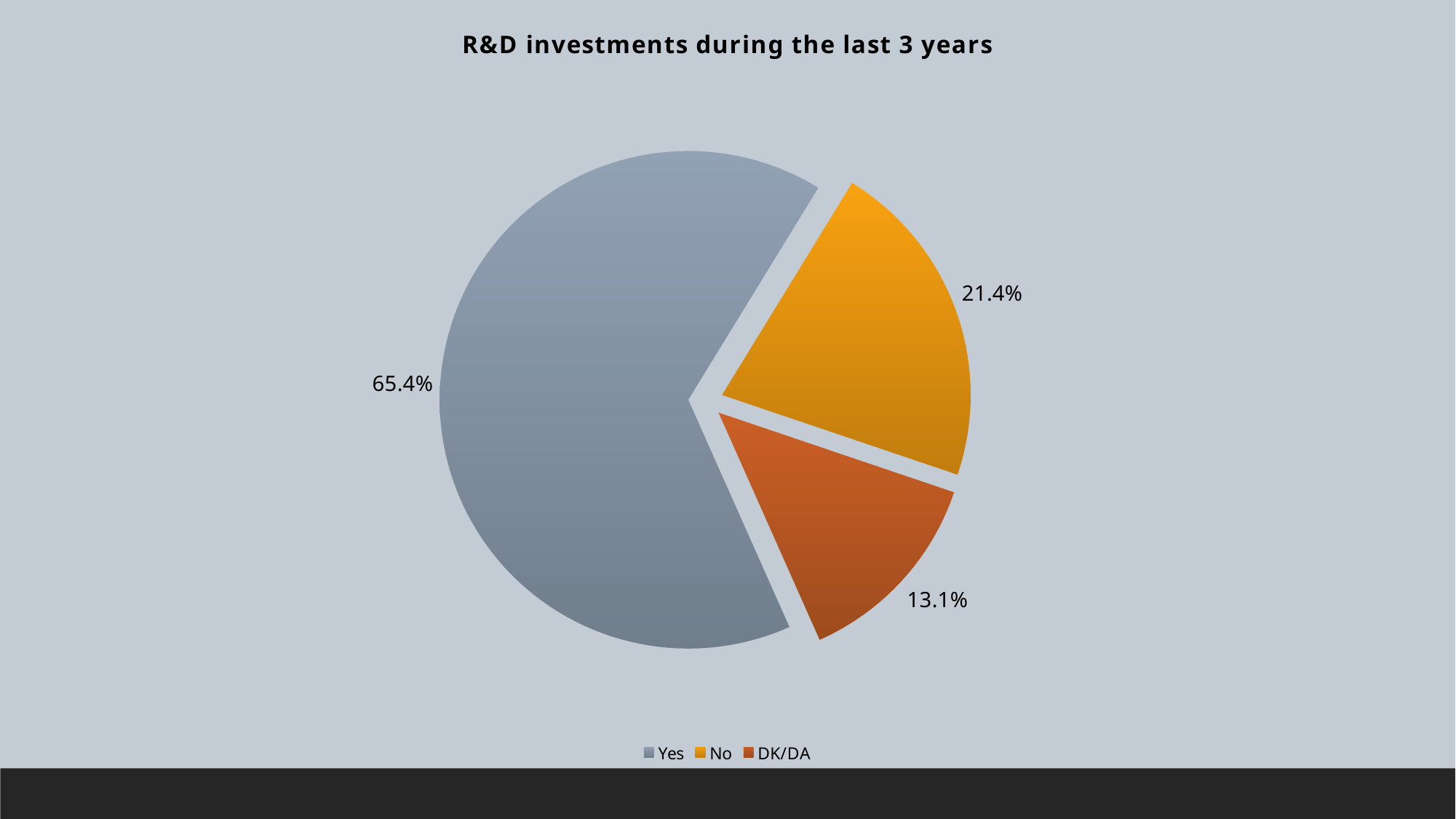
What share of the pie is labelled "Yes"? 65.4% What share of the pie is labelled "DK/DA"? 13.1% Which category has the smallest slice of the pie? DK/DA What is the title of the chart? R&D investments during the last 3 years What kind of chart is shown on the slide? pie chart What is the difference in percentage points between the "No" and "DK/DA" slices? 8.3 Which category has the largest slice of the pie? Yes How many slices does the pie chart have? 3 How many entries does the legend list? 3 What share of the pie is labelled "No"? 21.4% Which slice is larger, "No" or "DK/DA"? No What colour is the "Yes" slice? grey